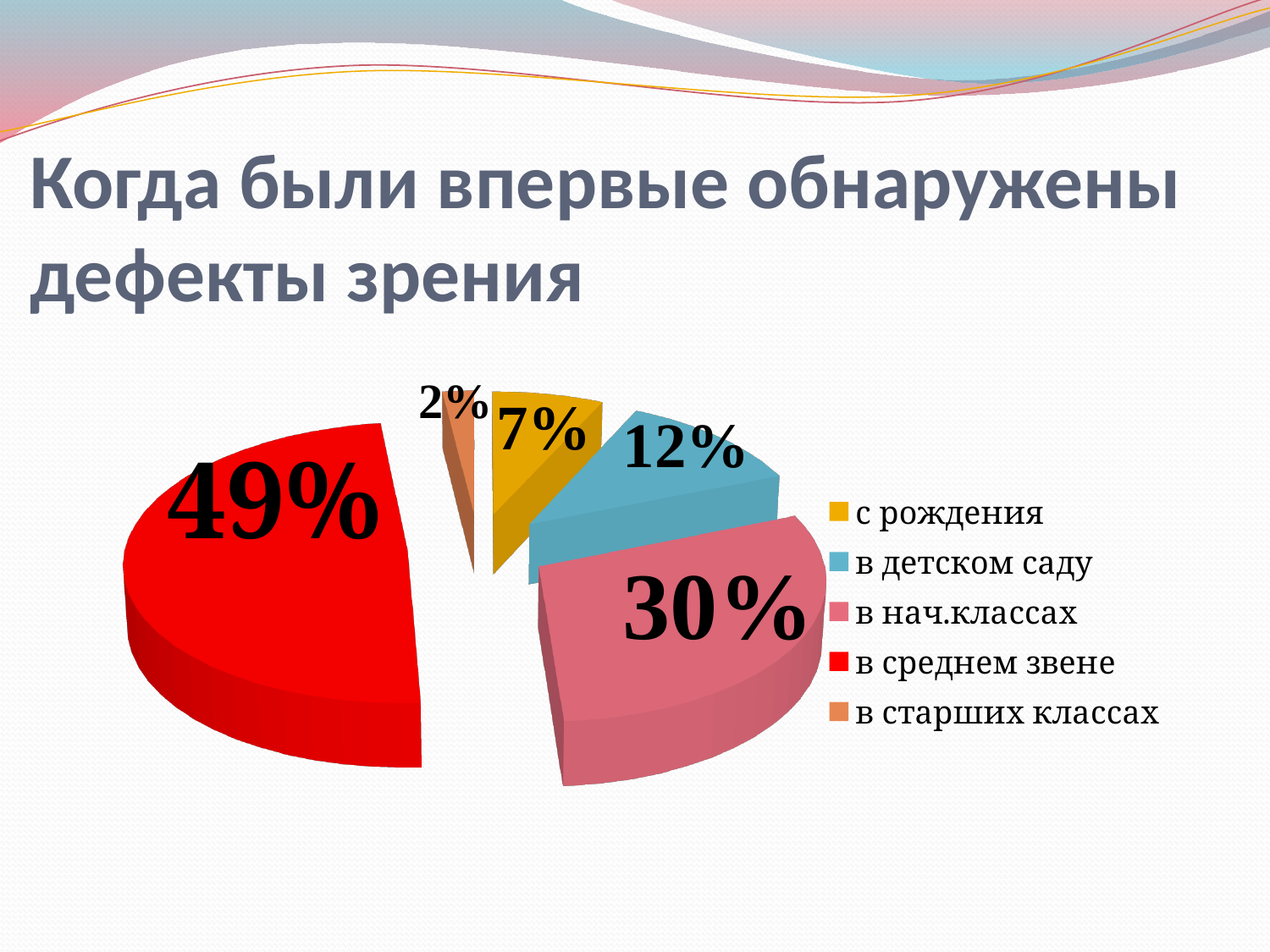
What percentage is shown for "в детском саду"? 12% How many categories does the legend list? 5 What percentage is shown for "в среднем звене"? 49% What kind of chart is shown on the slide? Pie chart What colour is the slice for "в детском саду"? Blue Which category has the largest share of the pie? в среднем звене What percentage is shown for "в нач.классах"? 30% What percentage is shown for "в старших классах"? 2% What percentage is shown for "с рождения"? 7% What is the difference between the shares for "в среднем звене" and "в нач.классах"? 19% Which is larger, the share for "в детском саду" or the share for "с рождения"? в детском саду Which category has the smallest share of the pie? в старших классах